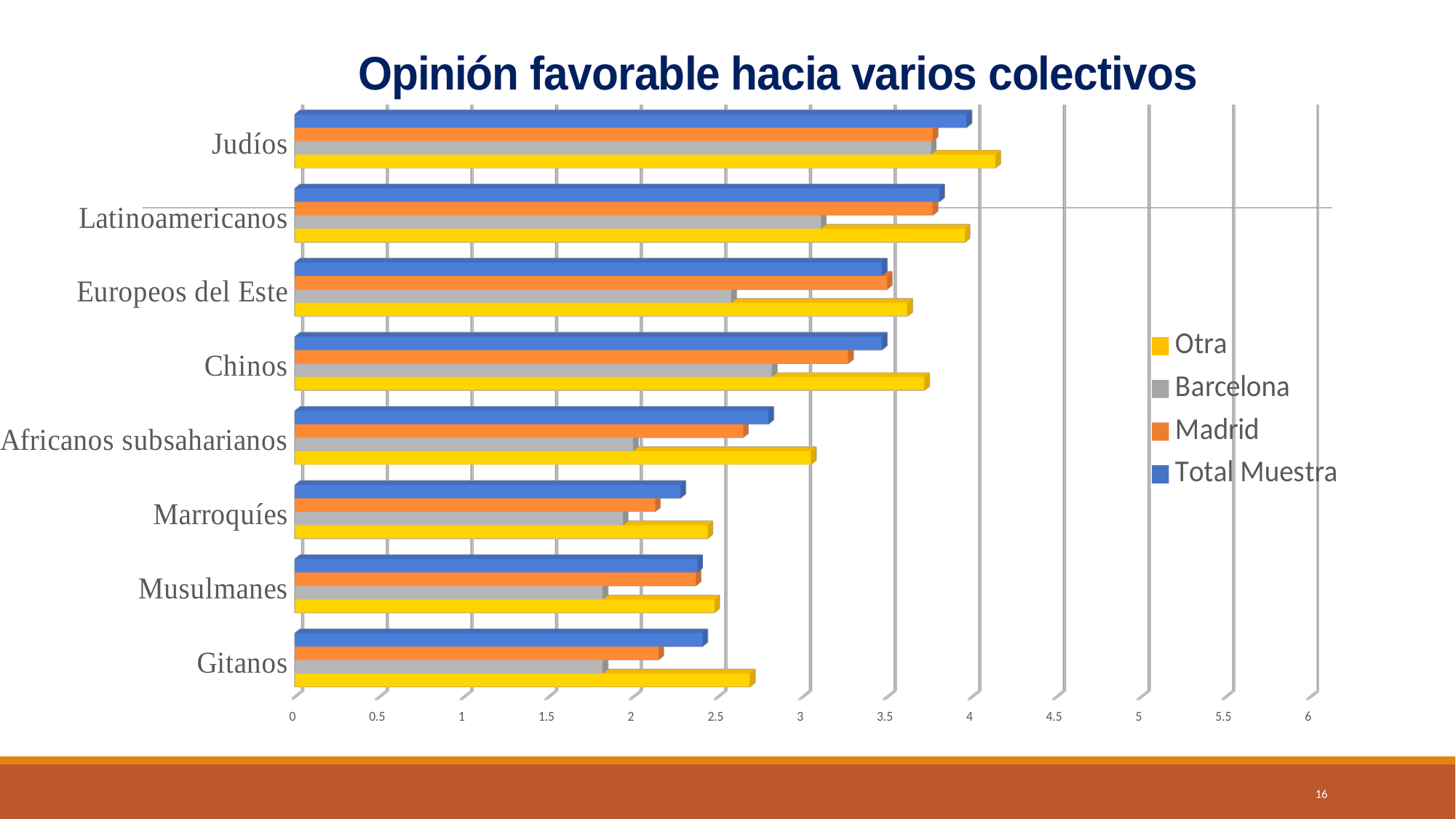
Is the Total Muestra value for Gitanos greater or less than 3? less Which category has the highest value for the Otra series? Judíos Which category has the highest value for the Barcelona series? Judíos For Latinoamericanos, which is larger: the Madrid value or the Barcelona value? Madrid What kind of chart is shown on the slide? bar chart How many groups (categories) are listed on the vertical axis of the chart? 8 For Chinos, which is larger: the Otra value or the Barcelona value? Otra Is the Otra value for Judíos greater or less than 4? greater What is the title of the chart? Opinión favorable hacia varios colectivos Is the Barcelona value for Africanos subsaharianos greater or less than 2.5? less How many series does the legend list? 4